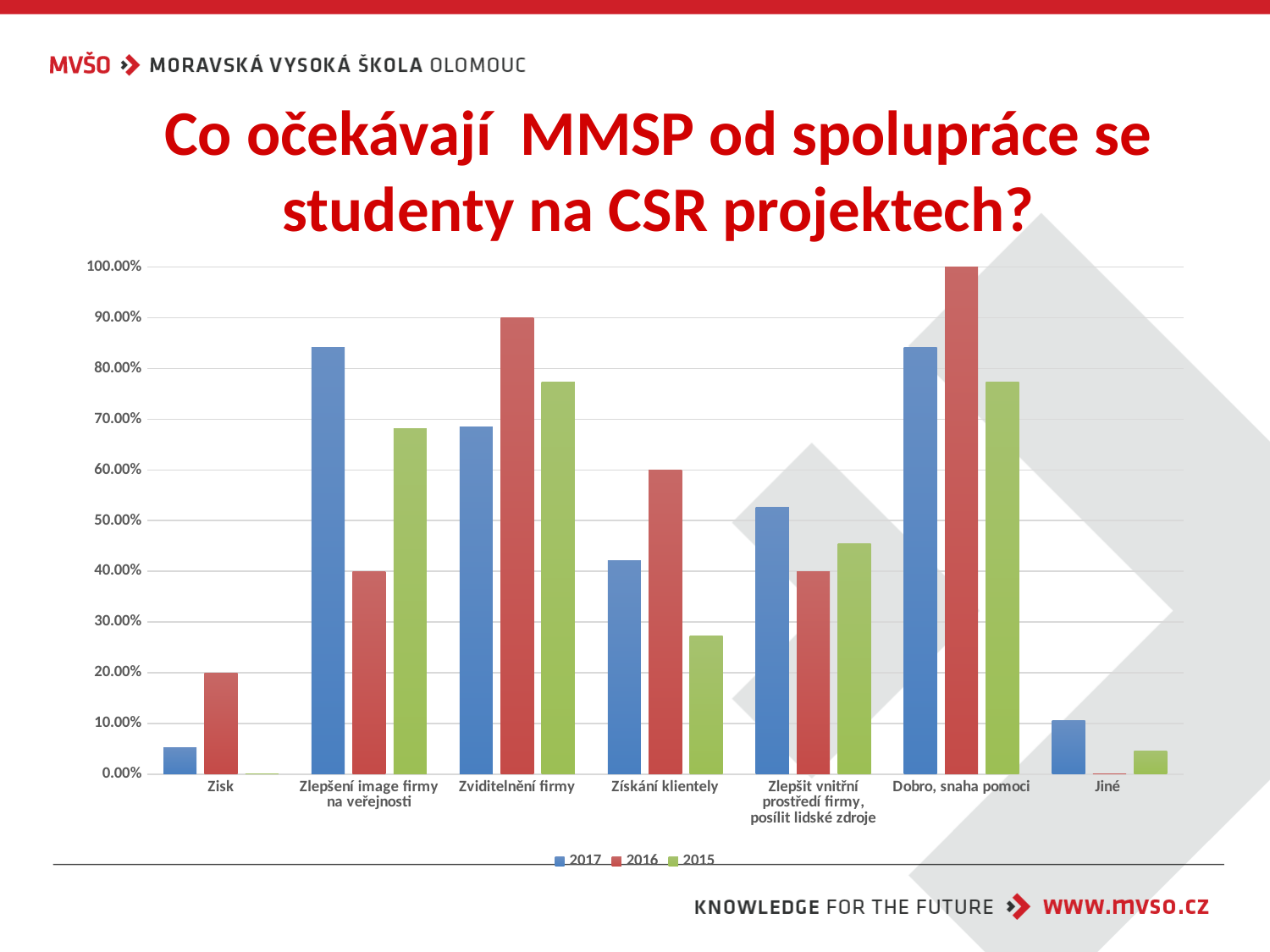
How many series does the legend list? 3 Is the value for 2015 in the category Získání klientely greater or less than 30.00%? less What is the value for 2016 in the category Zisk? 20.00% What is the value for 2016 in the category Zviditelnění firmy? 90.00% Which series are listed in the legend? 2017, 2016, 2015 What kind of chart is shown on the slide? bar chart Is the value for 2017 in the category Zlepšení image firmy na veřejnosti greater or less than 80.00%? greater How many categories are shown on the x axis? 7 Which category has the highest value for the 2016 series? Dobro, snaha pomoci What is the value for 2016 in the category Dobro, snaha pomoci? 100.00% In the category Získání klientely, which series has the larger value, 2017 or 2016? 2016 Which category has the lowest value for the 2017 series? Zisk